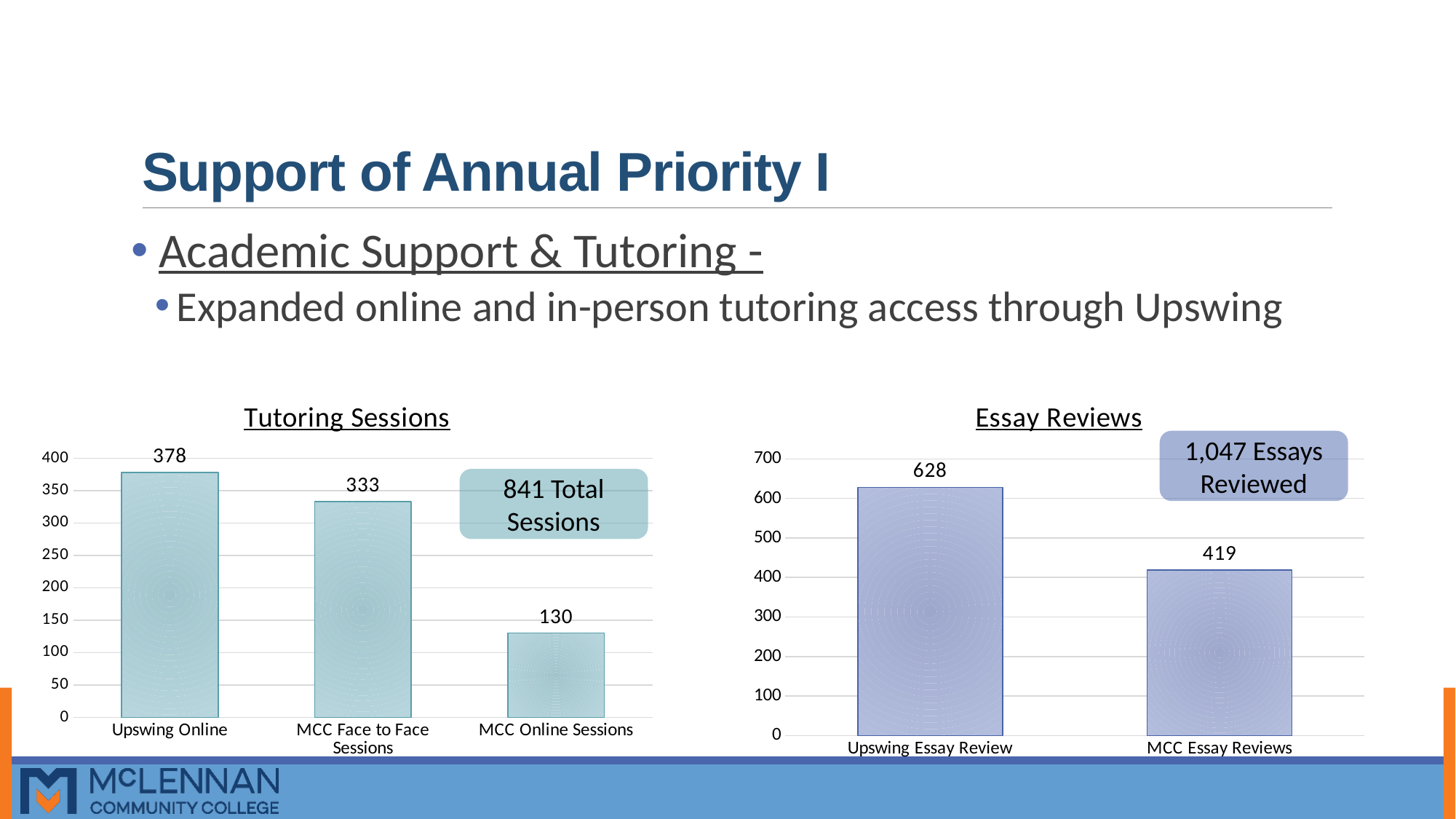
In the Tutoring Sessions chart, which category has the lowest value? MCC Online Sessions How many categories are shown in the Tutoring Sessions chart? 3 In the Essay Reviews chart, what is the value for MCC Essay Reviews? 419 According to the callout on the Tutoring Sessions chart, what is the total number of sessions? 841 In the Tutoring Sessions chart, which category has the highest value? Upswing Online In the Essay Reviews chart, which is larger, Upswing Essay Review or MCC Essay Reviews? Upswing Essay Review What type of chart is the Essay Reviews chart? Bar chart In the Tutoring Sessions chart, what is the value for MCC Online Sessions? 130 In the Tutoring Sessions chart, what is the difference between Upswing Online and MCC Face to Face Sessions? 45 In the Essay Reviews chart, what is the value for Upswing Essay Review? 628 In the Essay Reviews chart, what is the difference between Upswing Essay Review and MCC Essay Reviews? 209 In the Tutoring Sessions chart, what is the value for Upswing Online? 378